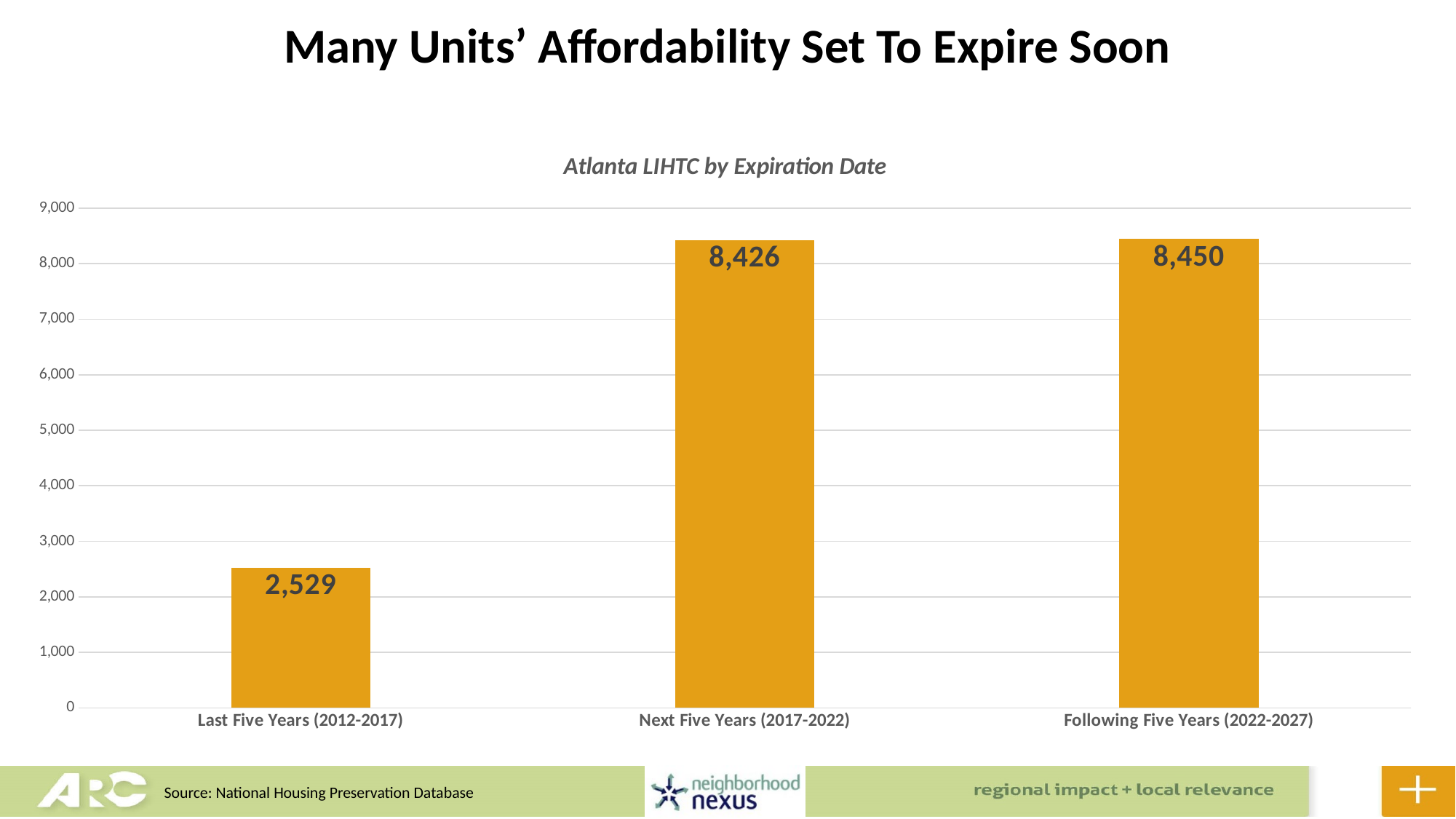
What is the title of the chart? Atlanta LIHTC by Expiration Date Is the value for Last Five Years (2012-2017) greater or less than 3,000? less What is the difference between the values for Next Five Years (2017-2022) and Last Five Years (2012-2017)? 5,897 Which is larger, the value for Last Five Years (2012-2017) or the value for Next Five Years (2017-2022)? Next Five Years (2017-2022) Which category has the highest value? Following Five Years (2022-2027) What is the difference between the values for Following Five Years (2022-2027) and Next Five Years (2017-2022)? 24 What kind of chart is shown on the slide? bar chart What is the value for Next Five Years (2017-2022)? 8,426 What is the value for Following Five Years (2022-2027)? 8,450 What is the value for Last Five Years (2012-2017)? 2,529 Which category has the lowest value? Last Five Years (2012-2017) How many categories are shown on the x axis? 3